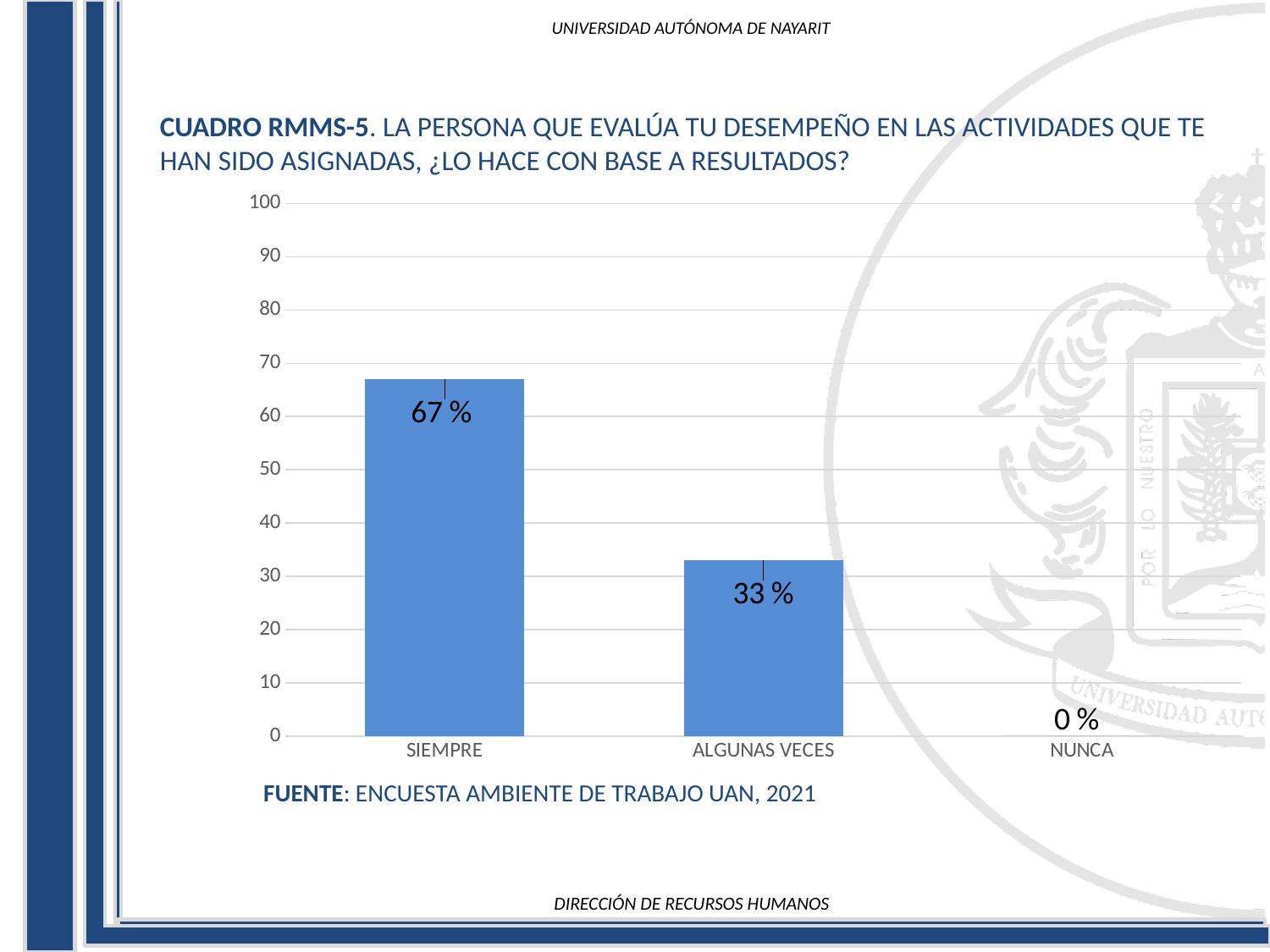
What is the difference between the values for SIEMPRE and ALGUNAS VECES? 34 % Is the value for ALGUNAS VECES greater or less than 40? less Which category has the lowest value? NUNCA Which category has the highest value? SIEMPRE How many categories are shown on the x axis? 3 Is the value for SIEMPRE greater or less than 60? greater What is the value for ALGUNAS VECES? 33 % What kind of chart is shown on the slide? bar chart Which is larger, the value for SIEMPRE or the value for ALGUNAS VECES? SIEMPRE What is the value for NUNCA? 0 % What is the value for SIEMPRE? 67 % What is the source cited below the chart? ENCUESTA AMBIENTE DE TRABAJO UAN, 2021